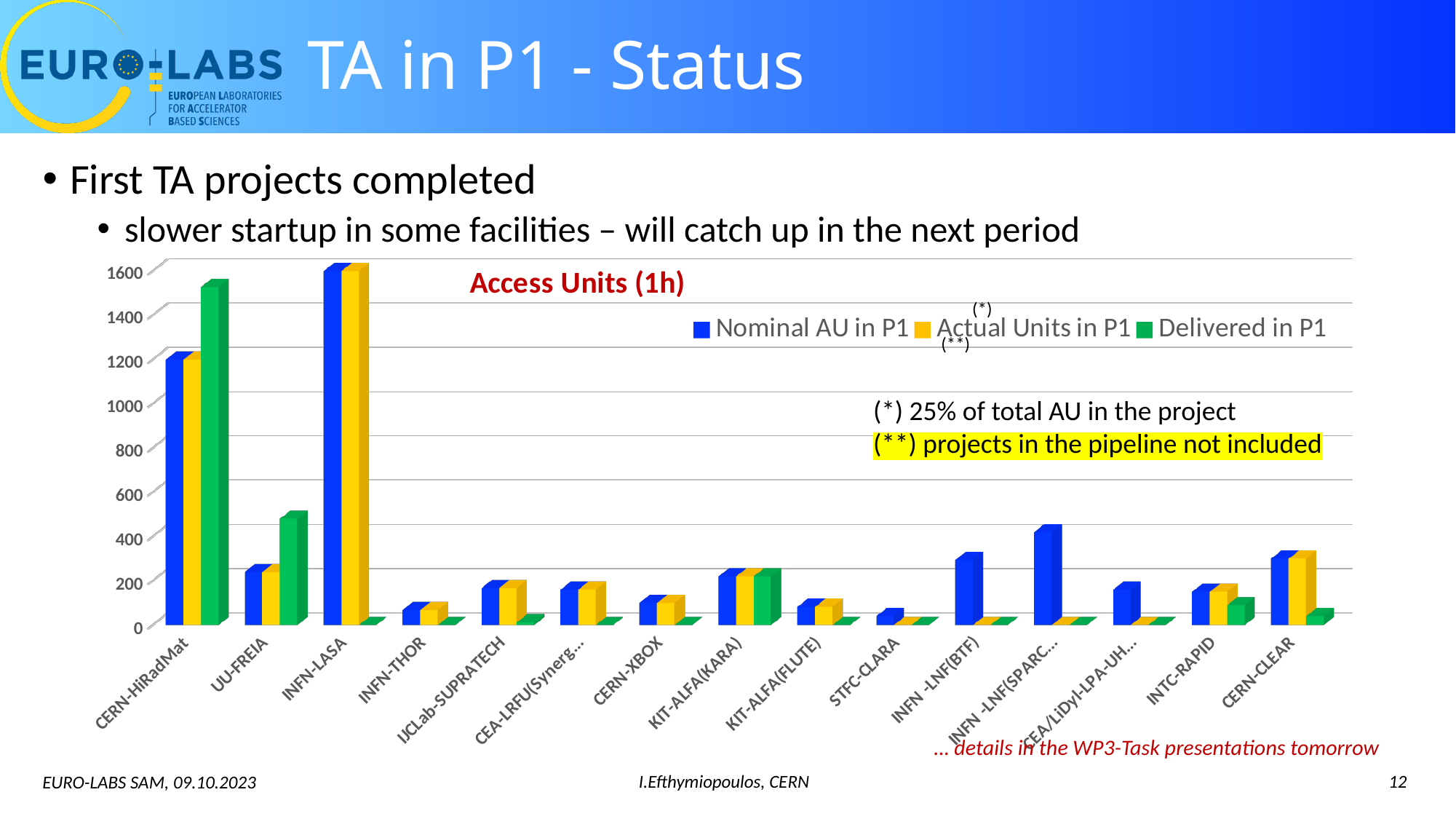
Which facility has the highest Delivered in P1 value? CERN-HiRadMat How many series does the chart legend list? 3 Is the Nominal AU in P1 for INFN -LNF(BTF) greater or less than 200? greater Which is larger: the Nominal AU in P1 for INFN-LASA or for CERN-HiRadMat? INFN-LASA What is the title shown in red above the chart? Access Units (1h) What kind of chart is shown on the slide? bar chart Which is larger: the Delivered in P1 value for CERN-HiRadMat or for UU-FREIA? CERN-HiRadMat Which facility has the highest Nominal AU in P1? INFN-LASA Is the Nominal AU in P1 for CERN-HiRadMat greater or less than 1000? greater Is the Delivered in P1 value for UU-FREIA greater or less than 400? greater How many facilities (categories) are shown on the x axis of the chart? 15